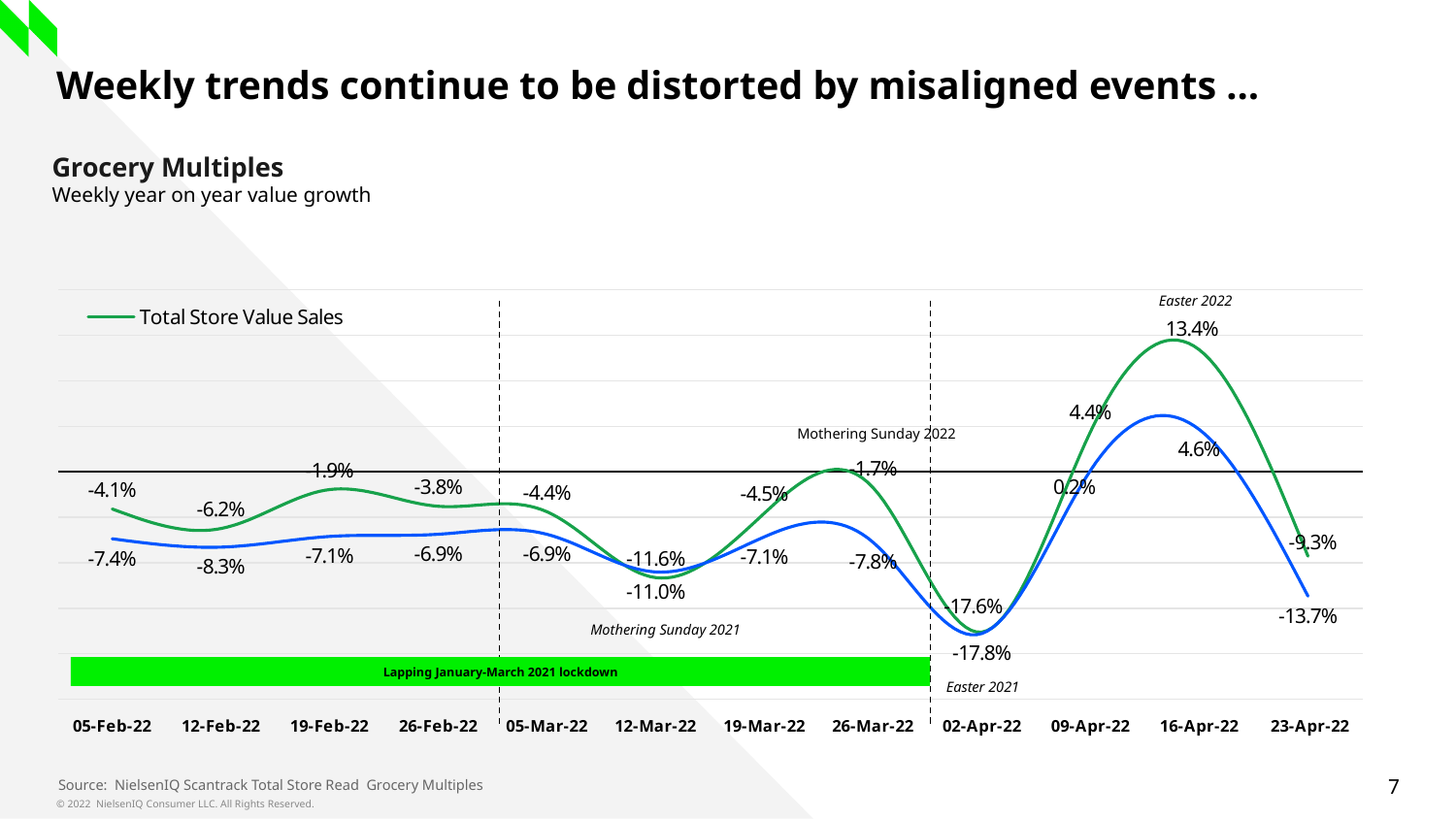
What is the Total Store Value Sales growth for the week of 16-Apr-22? 13.4% How many series does the chart legend list? 1 What is the Total Store Value Sales growth for the week of 05-Feb-22? -4.1% How many weekly dates are shown on the x axis of the chart? 12 What is the Total Store Value Sales growth for the week of 23-Apr-22? -9.3% In which week does the Total Store Value Sales line reach its lowest value? 02-Apr-22 Which event is annotated above the peak at 16-Apr-22 on the chart? Easter 2022 What is the name of the series listed in the chart legend? Total Store Value Sales Which week has the higher Total Store Value Sales growth, 19-Feb-22 or 26-Mar-22? 26-Mar-22 In which week does the Total Store Value Sales line reach its highest value? 16-Apr-22 What type of chart is shown on the slide? Line chart By how many percentage points does Total Store Value Sales growth increase from 09-Apr-22 (4.4%) to 16-Apr-22 (13.4%)? 9.0 percentage points